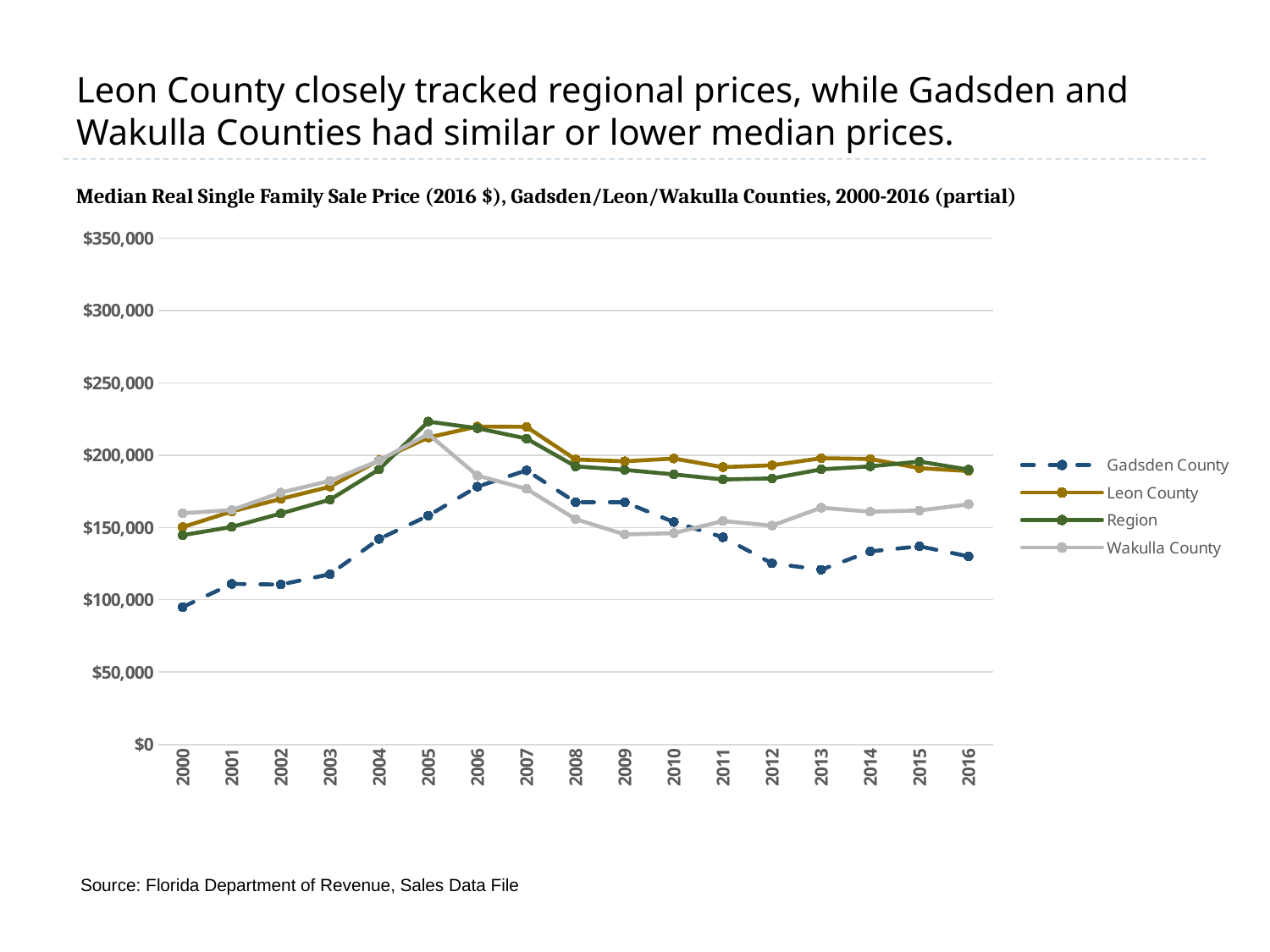
Is the value for Gadsden County in 2000 greater or less than $100,000? less Does the Wakulla County line rise or fall from 2005 to 2009? fall In 2007, which is larger: the value for Gadsden County or the value for Wakulla County? Gadsden County Is the value for Gadsden County in 2012 greater or less than $150,000? less In which year does the Gadsden County line reach its highest value? 2007 How many series does the legend list? 4 Which series has the lowest value in 2016? Gadsden County What kind of chart is shown on the slide? line chart Which series is drawn with a dashed line? Gadsden County Is the value for Region in 2005 greater or less than $200,000? greater How many years are plotted along the x axis? 17